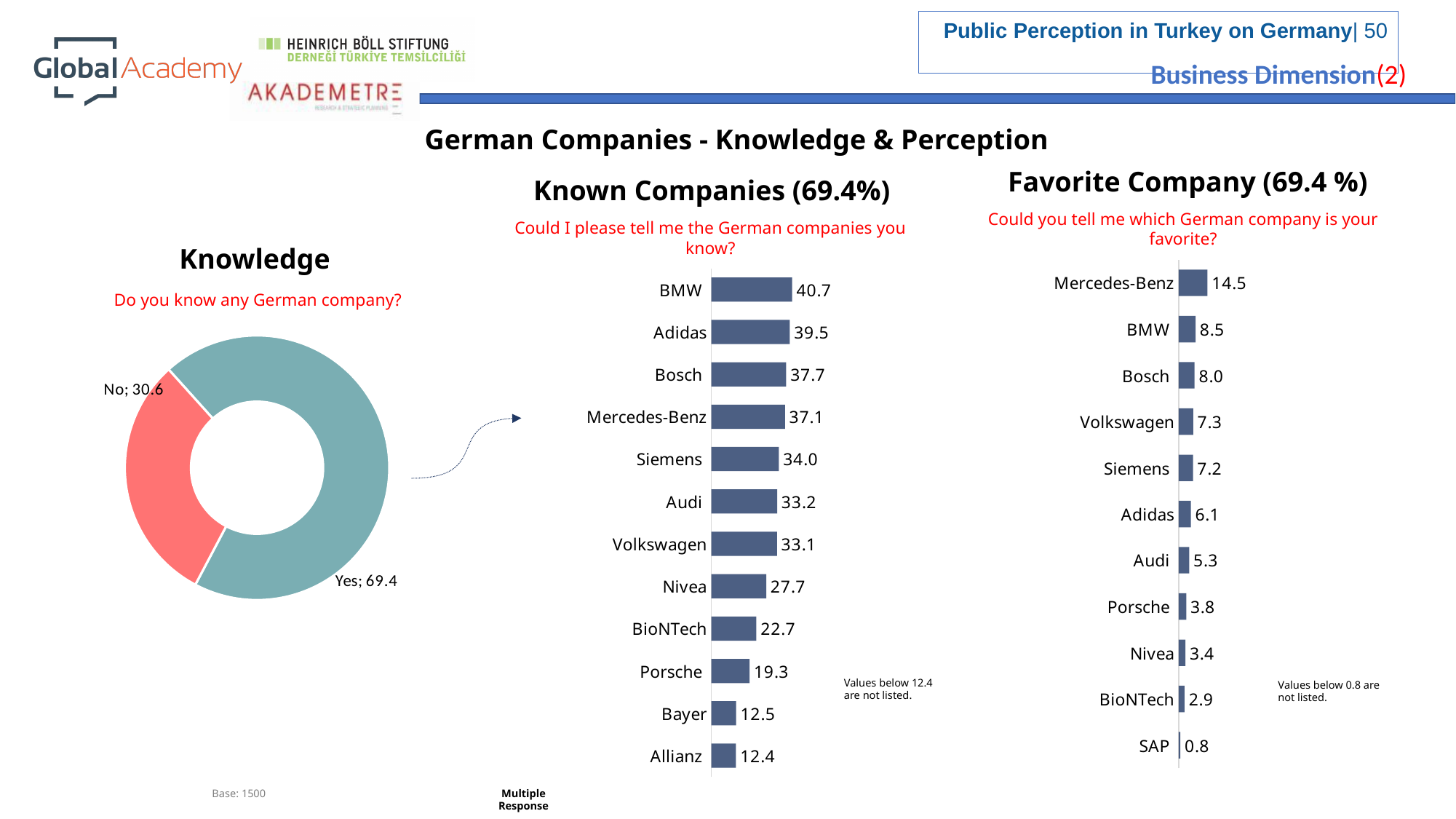
What kind of chart is the Knowledge chart? Donut (pie) chart In the Known Companies chart, which company has the lowest value? Allianz In the Known Companies chart, what is the value for Siemens? 34.0 How many companies are listed in the Known Companies chart? 12 In the Knowledge chart, what share of respondents answered No? 30.6 In the Favorite Company chart, what is the value for Volkswagen? 7.3 In the Known Companies chart, which company has the highest value? BMW In the Known Companies chart, what is the difference between BMW and Adidas? 1.2 In the Favorite Company chart, which company has the highest value? Mercedes-Benz In the Favorite Company chart, which is larger, Porsche or Nivea? Porsche In the Knowledge chart, what share of respondents answered Yes? 69.4 In the Favorite Company chart, what is the difference between Mercedes-Benz and BMW? 6.0